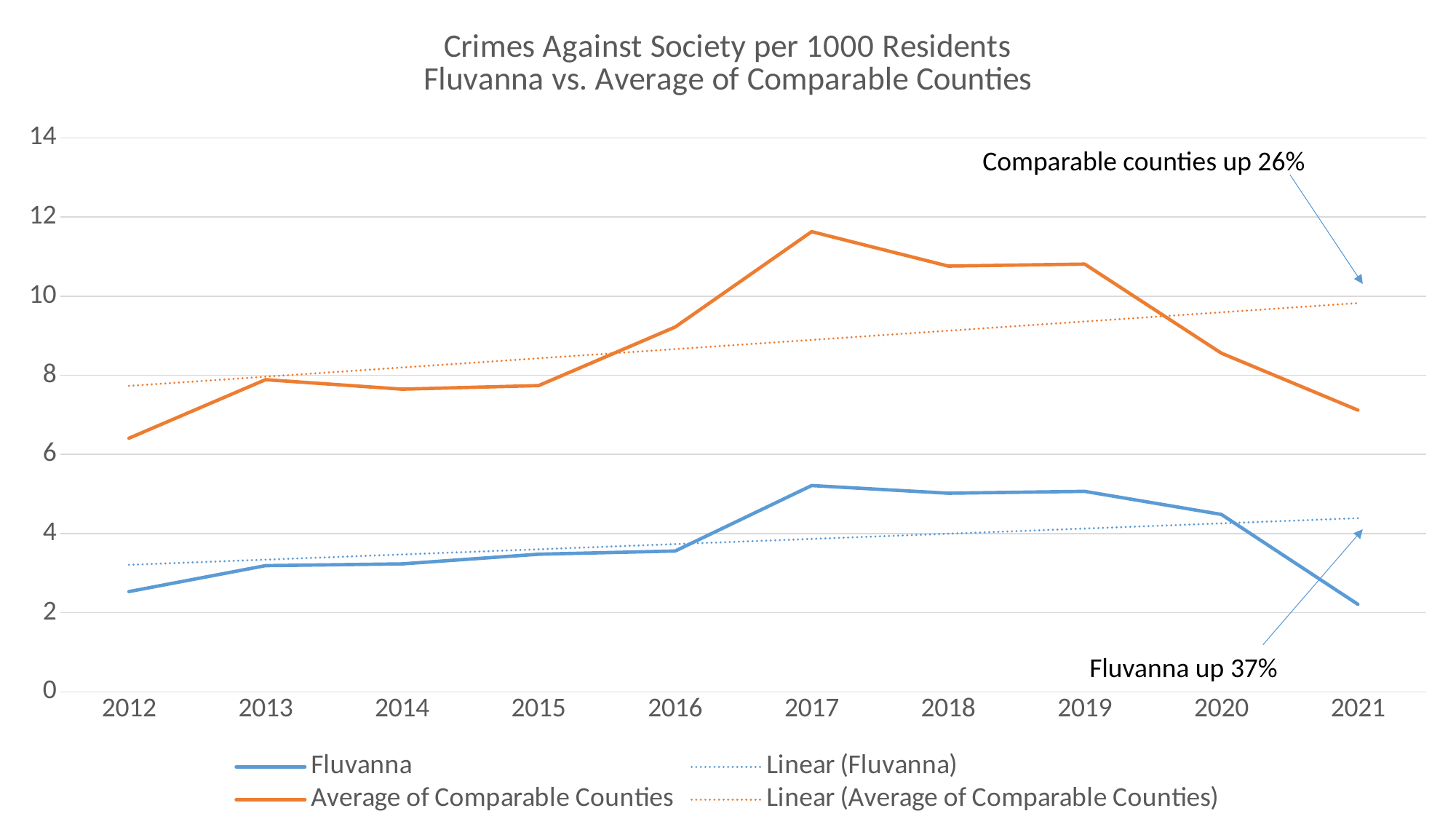
How many years are shown on the x axis? 10 How many entries does the legend list? 4 What kind of chart is shown on the slide? line chart In which year does the Fluvanna line reach its highest value? 2017 In which year is the Average of Comparable Counties value lowest? 2012 Is the Average of Comparable Counties value for 2017 greater or less than 10? greater Does the Fluvanna line rise or fall from 2019 to 2021? fall Is the Average of Comparable Counties value for 2012 greater or less than 8? less Is the Fluvanna value for 2021 greater or less than 4? less In which year does the Average of Comparable Counties line reach its highest value? 2017 In 2019, which series has the higher value, Fluvanna or Average of Comparable Counties? Average of Comparable Counties In which year is the Fluvanna value lowest? 2021